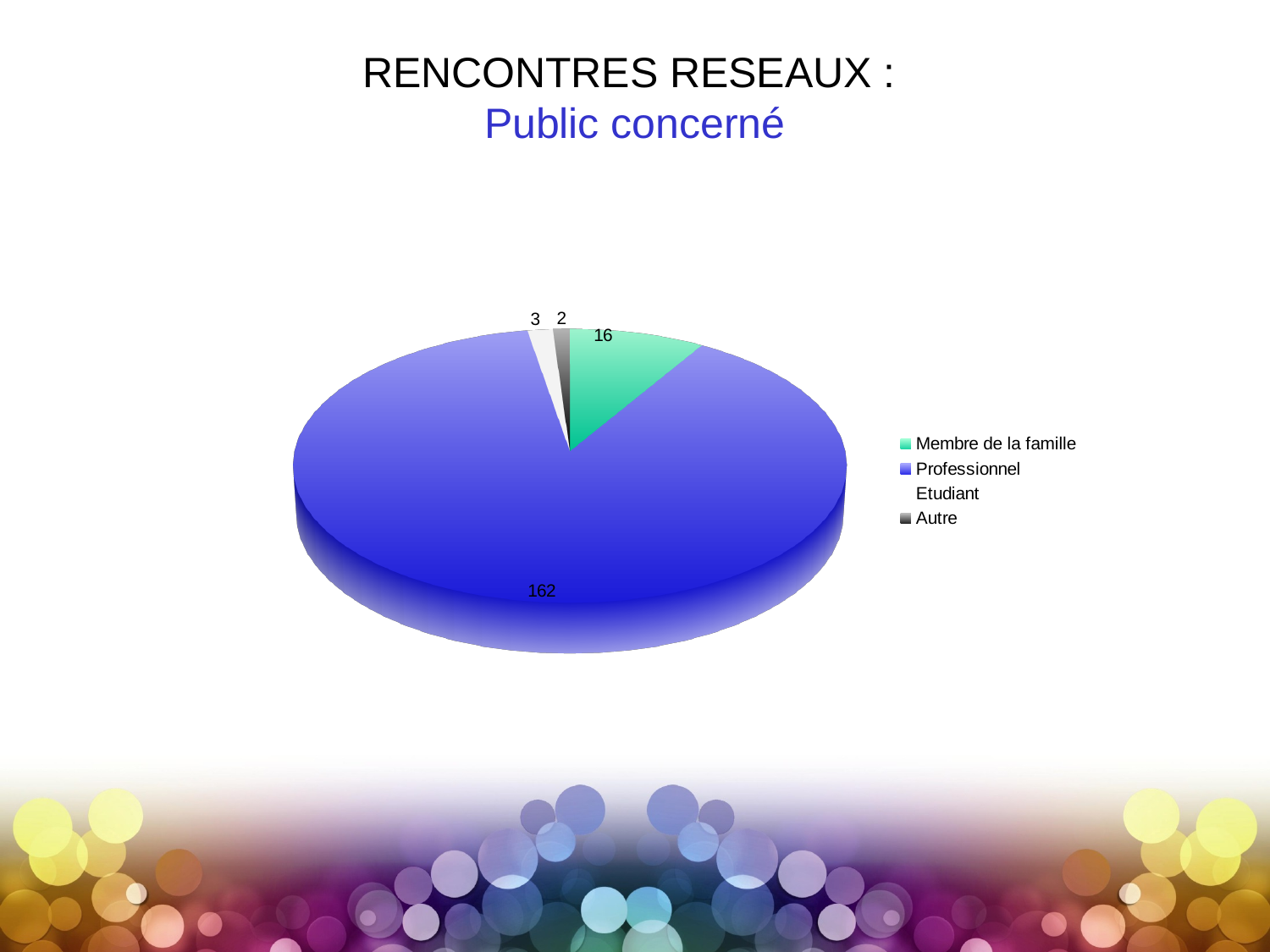
How many categories does the pie chart have? 4 What is the total of all the values shown in the pie chart? 183 Which category has the smallest slice of the pie? Autre What is the value for Etudiant? 3 What is the title of the slide containing the chart? RENCONTRES RESEAUX : Public concerné Which is larger, the value for Membre de la famille or the value for Etudiant? Membre de la famille What is the value for Membre de la famille? 16 What is the value for Autre? 2 Which category has the largest slice of the pie? Professionnel What is the value for Professionnel? 162 What is the difference between the values for Professionnel and Membre de la famille? 146 What type of chart is shown on the slide? Pie chart